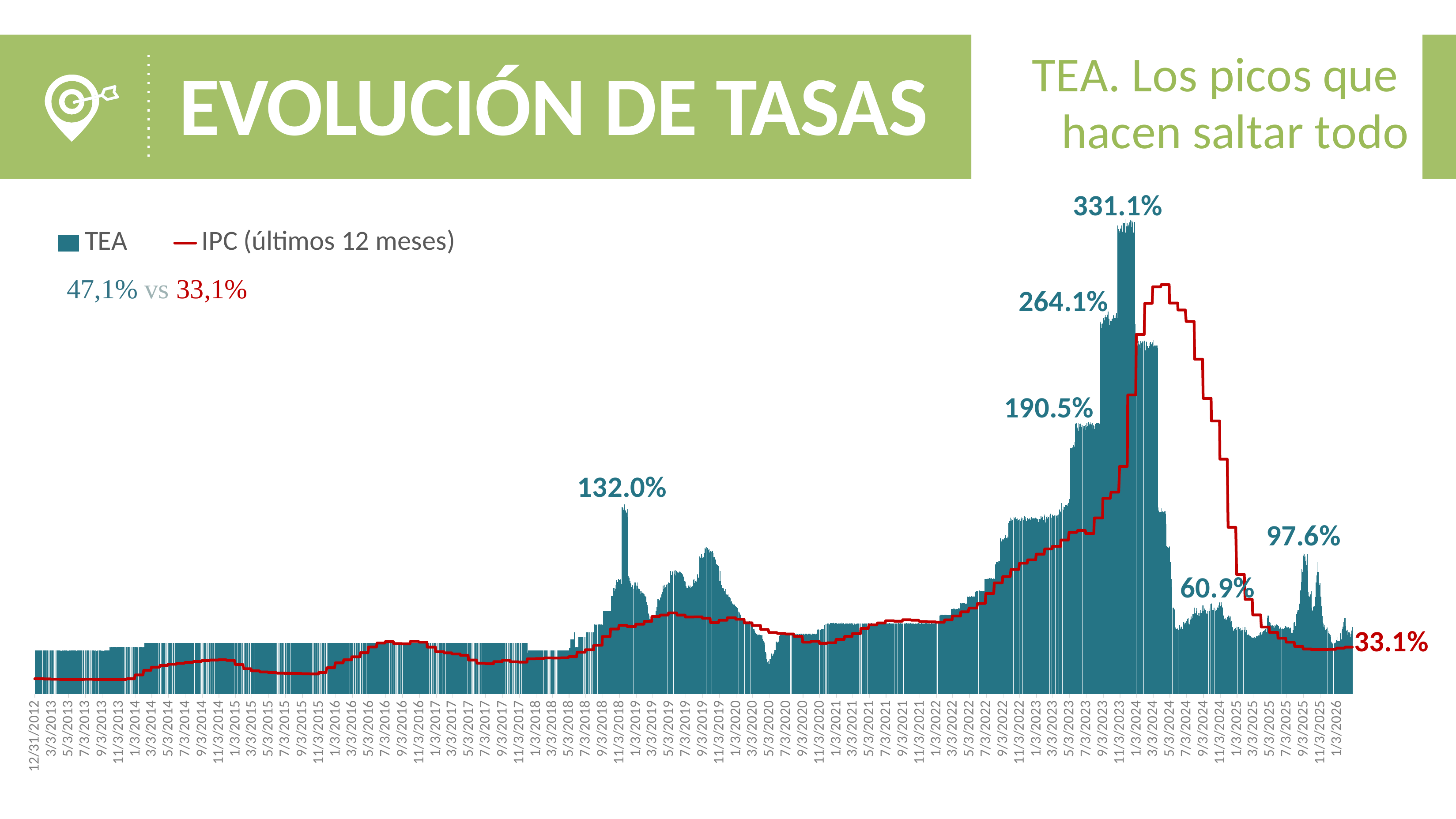
What is the difference between the labelled TEA values of 97.6% and 60.9%? 36.7 percentage points Which labelled TEA value is larger, 190.5% or 132.0%? 190.5% What is the highest TEA value labelled on the chart? 331.1% How many series does the legend list? 2 What is the final IPC (últimos 12 meses) value labelled at the right end of the red line? 33.1% What is the difference between the labelled TEA peaks of 331.1% and 264.1%? 67.0 percentage points What are the two legend entries of the chart? TEA and IPC (últimos 12 meses) Does the IPC line rise or fall between early 2024 and early 2026? fall What is the lowest TEA value labelled on the chart? 60.9% What TEA value is labelled at the peak in late 2025? 97.6% What TEA value is labelled at the spike around late 2018? 132.0% How many TEA data labels are printed on the chart? 6